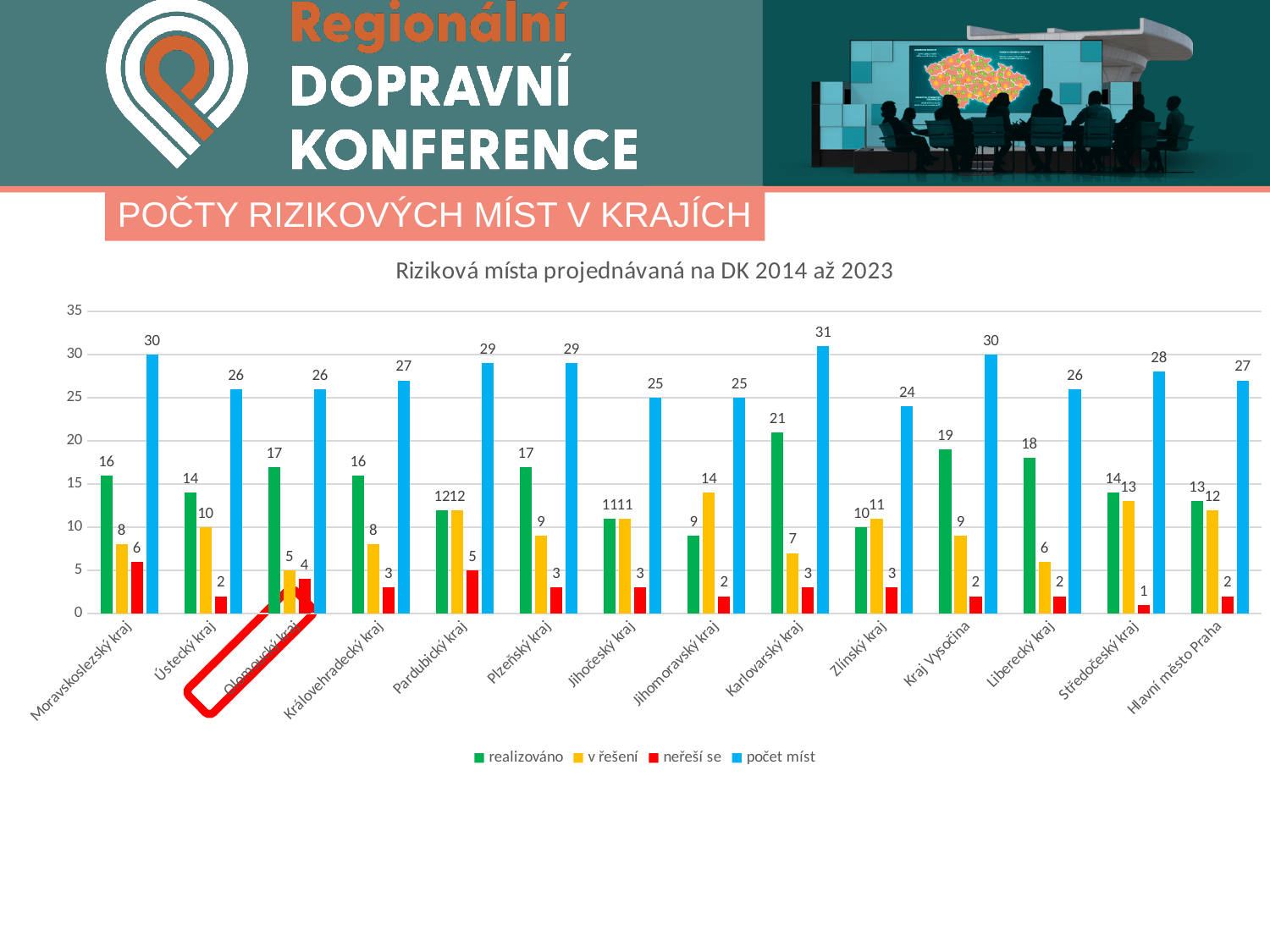
Which region has the lowest 'neřeší se' value? Středočeský kraj What is the title of the chart? Riziková místa projednávaná na DK 2014 až 2023 What is the value of 'realizováno' for Kraj Vysočina? 19 How many regions (categories) are shown on the x axis? 14 What type of chart is shown on the slide? bar chart Which is larger for Moravskoslezský kraj: 'realizováno' or 'v řešení'? realizováno What is the value of 'v řešení' for Jihomoravský kraj? 14 How many series does the legend list? 4 Which region has the lowest 'počet míst' value? Zlínský kraj Which region has the highest 'počet míst' value? Karlovarský kraj What is the difference between 'počet míst' and 'realizováno' for Liberecký kraj? 8 What is the value of 'počet míst' for Karlovarský kraj? 31